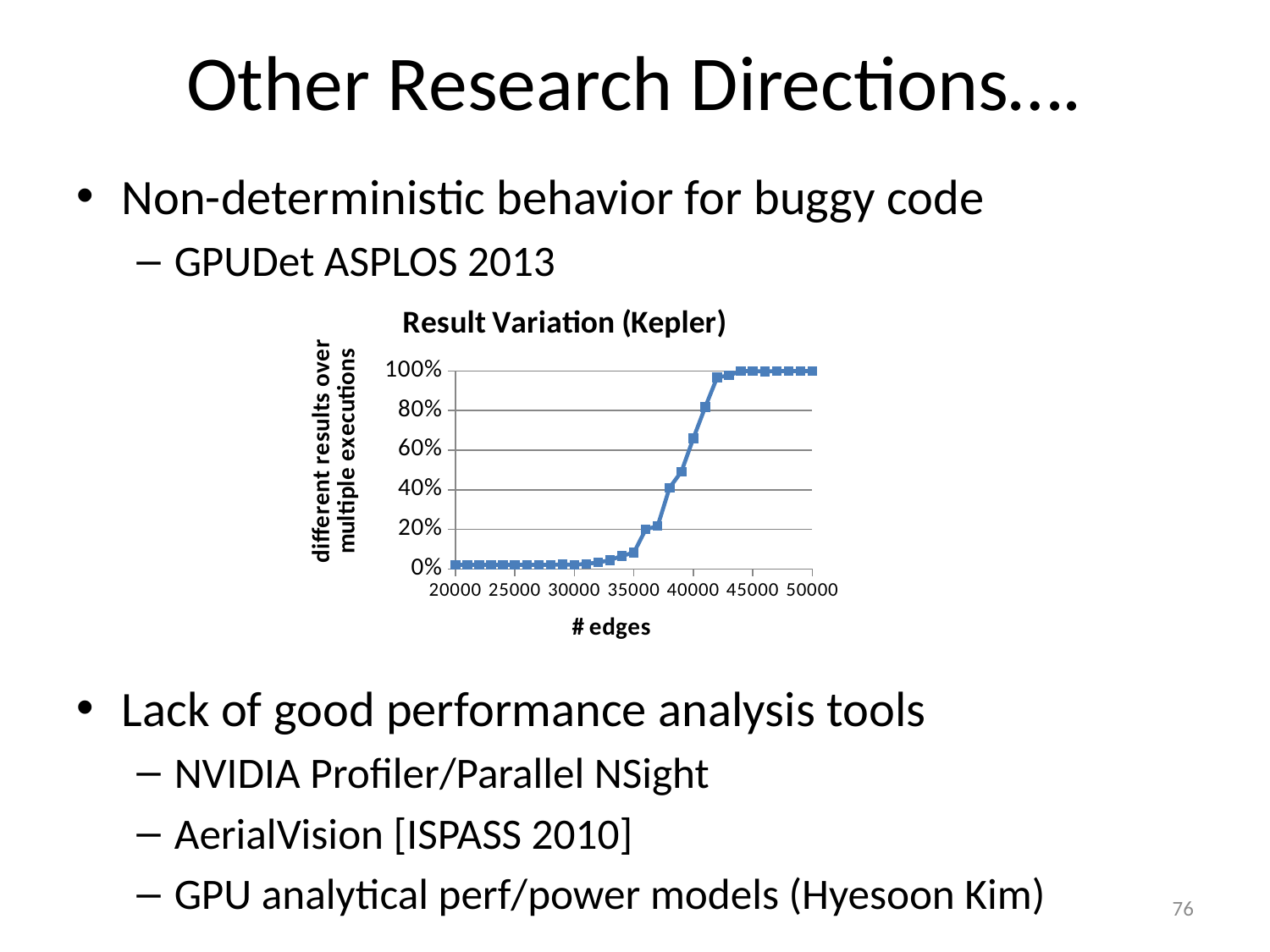
What is the value plotted at 50000 edges? 100% Is the value at 30000 edges greater or less than 20%? less What kind of chart is shown on the slide? line chart Is the value at 45000 edges greater or less than 80%? greater What is the label of the x axis of the chart? # edges Is the value at 40000 edges greater or less than 40%? greater What is the highest value reached by the line? 100% What is the title of the chart? Result Variation (Kepler) Do the values rise or fall as the number of edges increases from 20000 to 50000? rise Which is larger, the value at 35000 edges or the value at 40000 edges? 40000 edges